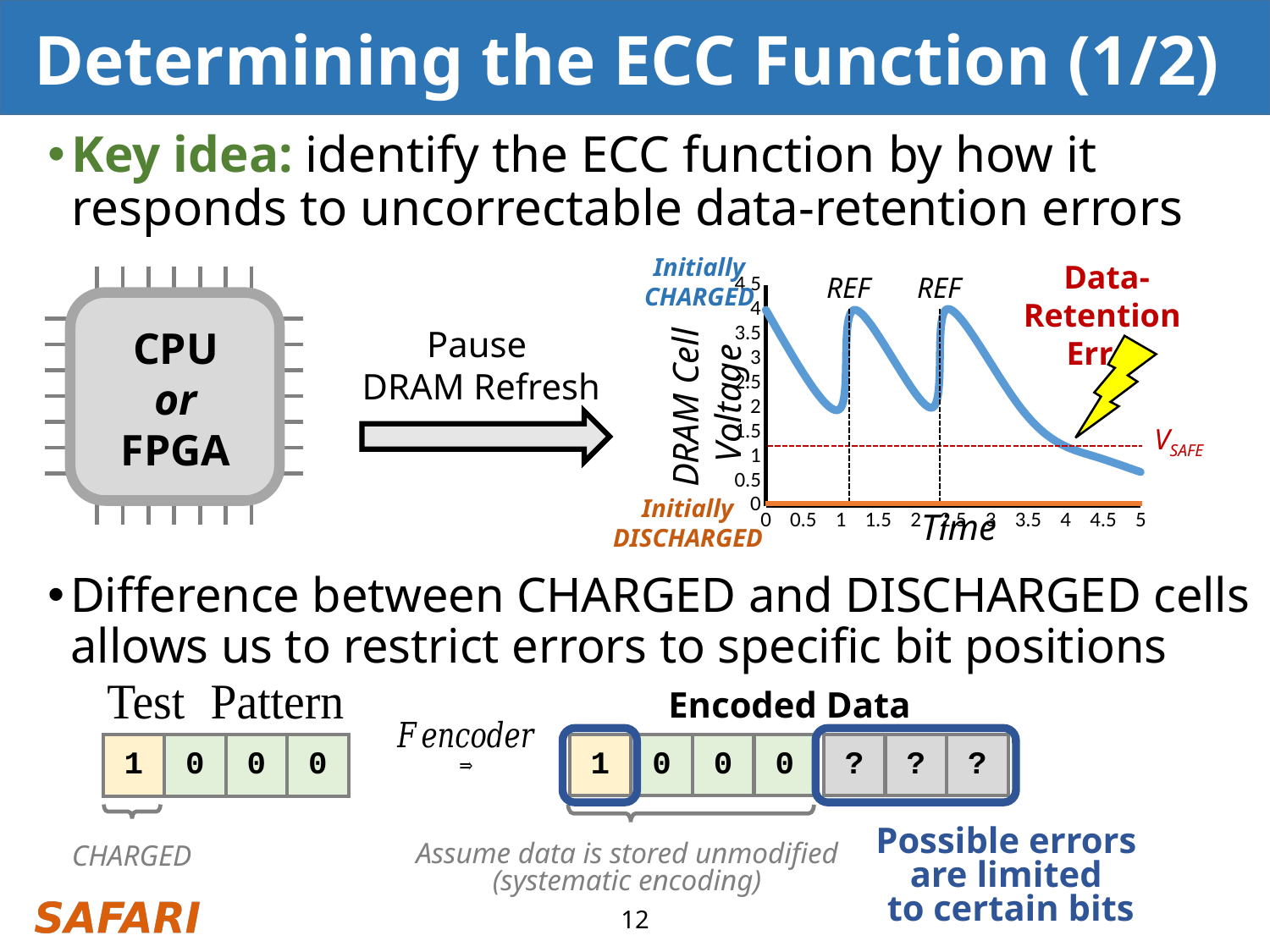
Is the Initially DISCHARGED voltage at Time 2 greater or less than 1? less Is the Initially CHARGED voltage at Time 5 greater or less than 1? less Is the Initially CHARGED voltage at Time 0 greater or less than 3? greater What kind of chart is shown on the slide? line chart How many series are plotted in the DRAM cell voltage chart? 2 At Time 5, which series has the higher voltage, Initially CHARGED or Initially DISCHARGED? Initially CHARGED How many REF (refresh) events are marked on the chart? 2 Overall, does the Initially CHARGED voltage rise or fall from Time 0 to Time 5? fall What is the label of the x axis of the chart? Time What is the label of the y axis of the chart? DRAM Cell Voltage What is the highest tick value shown on the x axis? 5